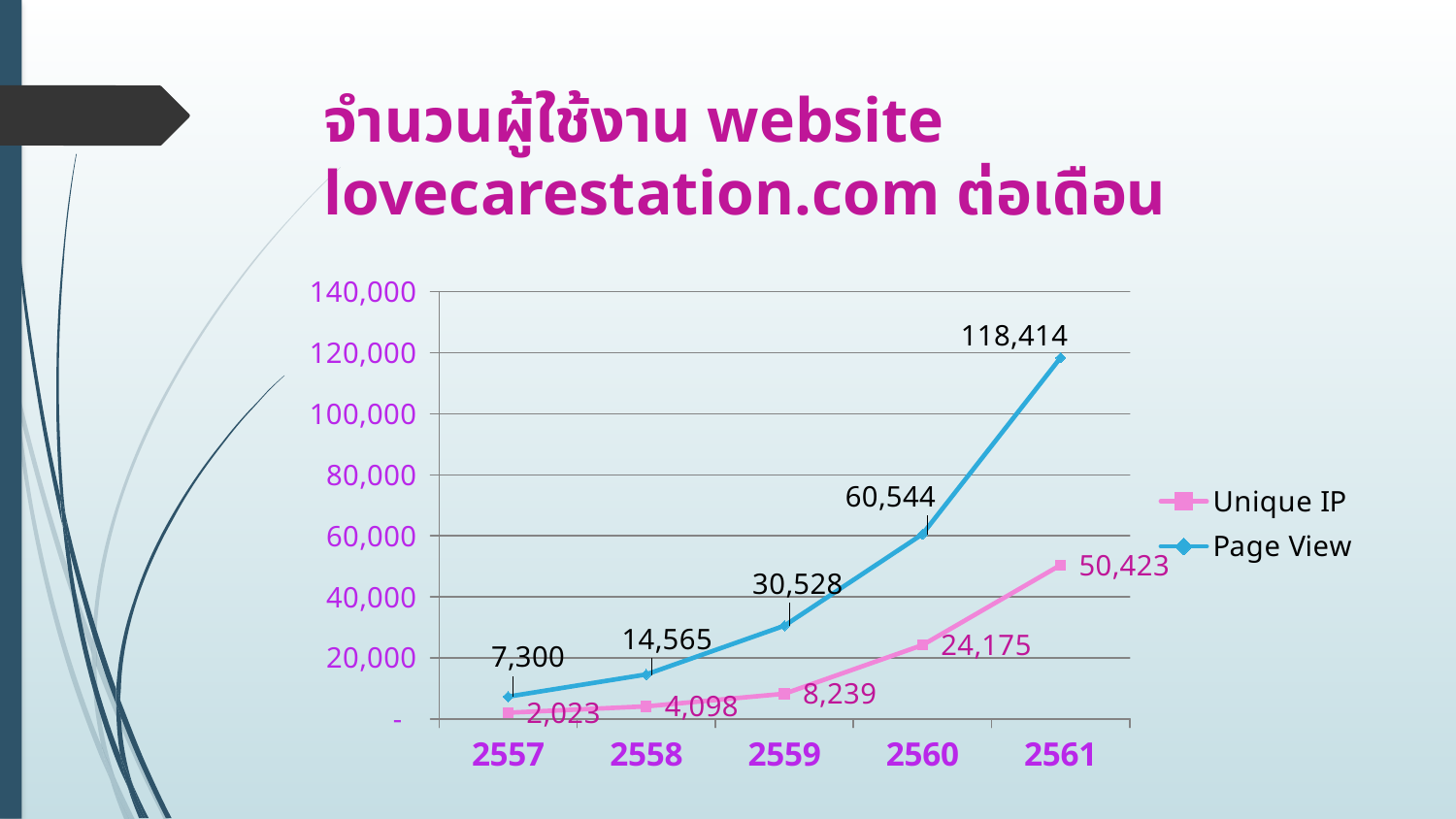
How many years are shown on the x axis? 5 What is the Unique IP value for 2559? 8,239 Which is larger in 2558: Page View or Unique IP? Page View In which year is the Page View value lowest? 2557 What is the Page View value for 2557? 7,300 In which year is the Unique IP value highest? 2561 What is the difference between Page View and Unique IP in 2561? 67,991 What kind of chart is shown on the slide? line chart Is the Page View value for 2560 greater or less than 80,000? less How many series does the legend list? 2 What is the Page View value for 2561? 118,414 What is the Unique IP value for 2560? 24,175